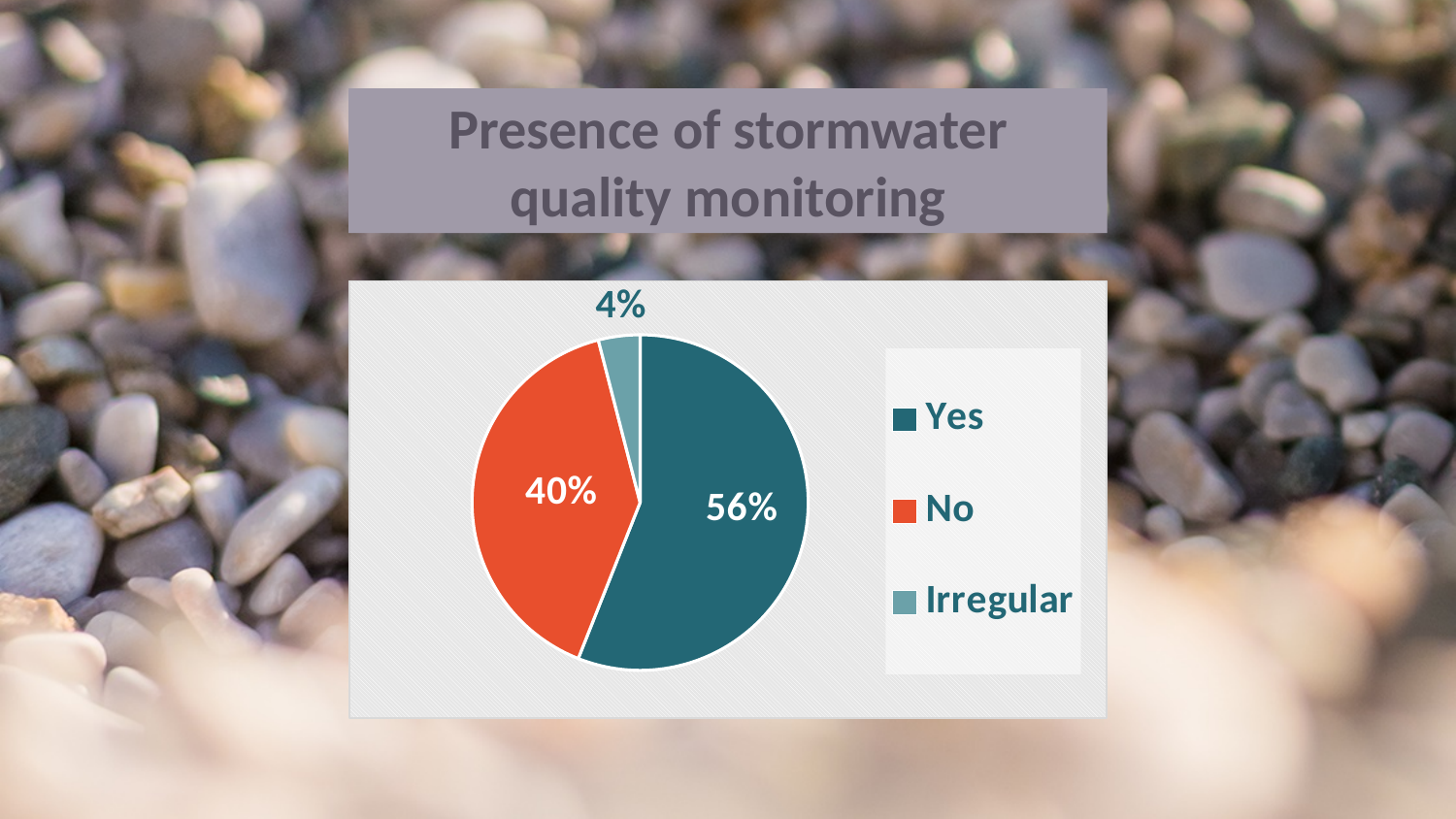
What percentage of the pie is labelled "Irregular"? 4% Which category has the smallest share of the pie? Irregular What kind of chart is shown on the slide? pie chart How many entries does the legend list? 3 What is the difference in percentage points between the "Yes" and "No" slices? 16 What percentage of the pie is labelled "Yes"? 56% How many slices does the pie chart have? 3 Which category has the largest share of the pie? Yes What colour is the "No" slice in the pie chart? orange What is the title of the chart? Presence of stormwater quality monitoring Which is larger, the "No" slice or the "Irregular" slice? No What percentage of the pie is labelled "No"? 40%